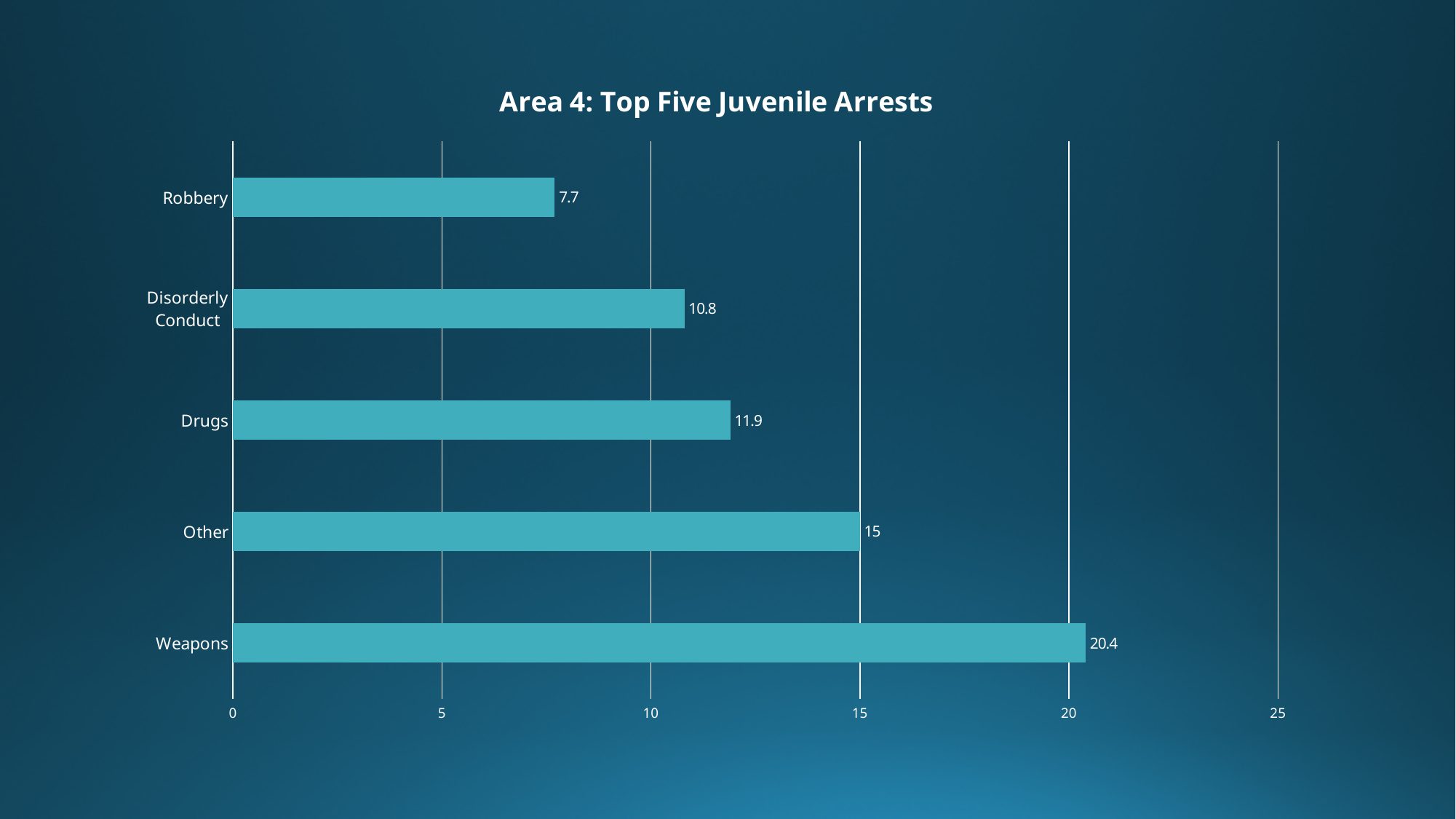
Which is larger, the value for Drugs or the value for Robbery? Drugs What is the difference between the values for Drugs and Disorderly Conduct? 1.1 Which category has the lowest value? Robbery What is the value for Weapons? 20.4 How many categories are shown in the chart? 5 What is the difference between the values for Weapons and Other? 5.4 What kind of chart is shown on the slide? Bar chart What is the title of the chart? Area 4: Top Five Juvenile Arrests Which category has the highest value? Weapons Is the value for Other greater or less than 10? greater What is the value for Disorderly Conduct? 10.8 What is the value for Robbery? 7.7